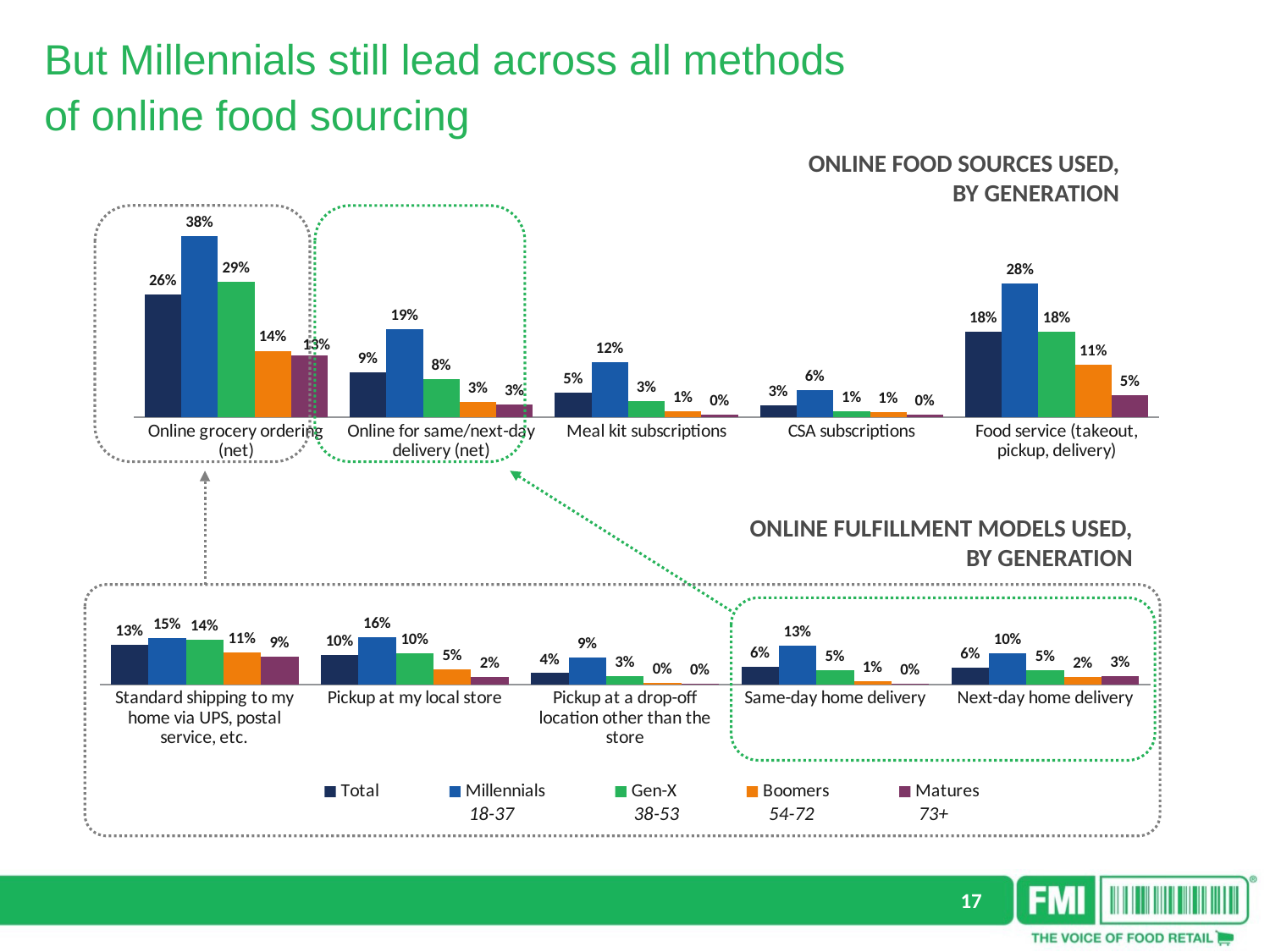
In the 'Online fulfillment models used, by generation' chart, what is the Millennials value for Pickup at my local store? 16% In the 'Online food sources used, by generation' chart, which is larger for Meal kit subscriptions: the Total value or the Gen-X value? Total In the 'Online food sources used, by generation' chart, what is the Millennials value for Online grocery ordering (net)? 38% In the 'Online food sources used, by generation' chart, what is the difference between the Millennials and Gen-X values for Online for same/next-day delivery (net)? 11% In the 'Online fulfillment models used, by generation' chart, what is the difference between the Millennials and Total values for Same-day home delivery? 7% What type of chart is the 'Online fulfillment models used, by generation' chart? Bar chart In the 'Online fulfillment models used, by generation' chart, what is the Matures value for Next-day home delivery? 3% How many series does the legend list for the charts on this slide? 5 In the 'Online fulfillment models used, by generation' chart, which category has the lowest Matures value? Pickup at a drop-off location other than the store and Same-day home delivery (both 0%) In the 'Online food sources used, by generation' chart, which category has the highest Millennials value? Online grocery ordering (net) In the 'Online food sources used, by generation' chart, what is the Boomers value for Food service (takeout, pickup, delivery)? 11% How many categories are shown on the x axis of the 'Online food sources used, by generation' chart? 5